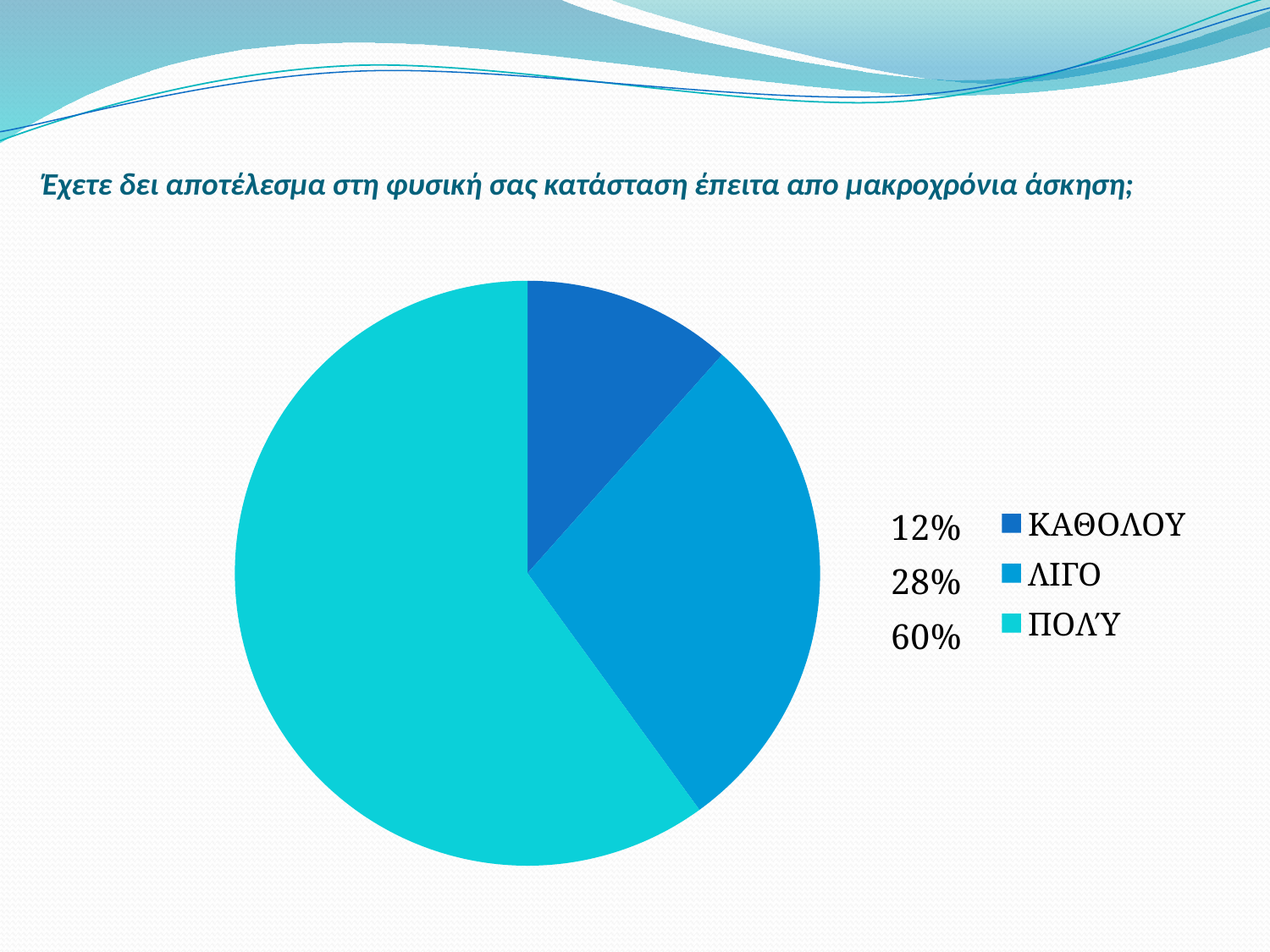
What is the difference in percentage points between the ΠΟΛΎ slice and the ΛΙΓΟ slice? 32% Which category has the smallest slice of the pie? ΚΑΘΟΛΟΥ How many categories does the pie chart show? 3 What kind of chart is shown on the slide? pie chart What share of the pie does ΛΙΓΟ represent? 28% Which category has the largest slice of the pie? ΠΟΛΎ Which is larger, the slice for ΛΙΓΟ or the slice for ΚΑΘΟΛΟΥ? ΛΙΓΟ What share of the pie does ΠΟΛΎ represent? 60% Which legend entry is shown with the darkest blue colour? ΚΑΘΟΛΟΥ What is the question shown as the title above the pie chart? Έχετε δει αποτέλεσμα στη φυσική σας κατάσταση έπειτα απο μακροχρόνια άσκηση; What share of the pie does ΚΑΘΟΛΟΥ represent? 12% What is the difference in percentage points between the ΛΙΓΟ slice and the ΚΑΘΟΛΟΥ slice? 16%